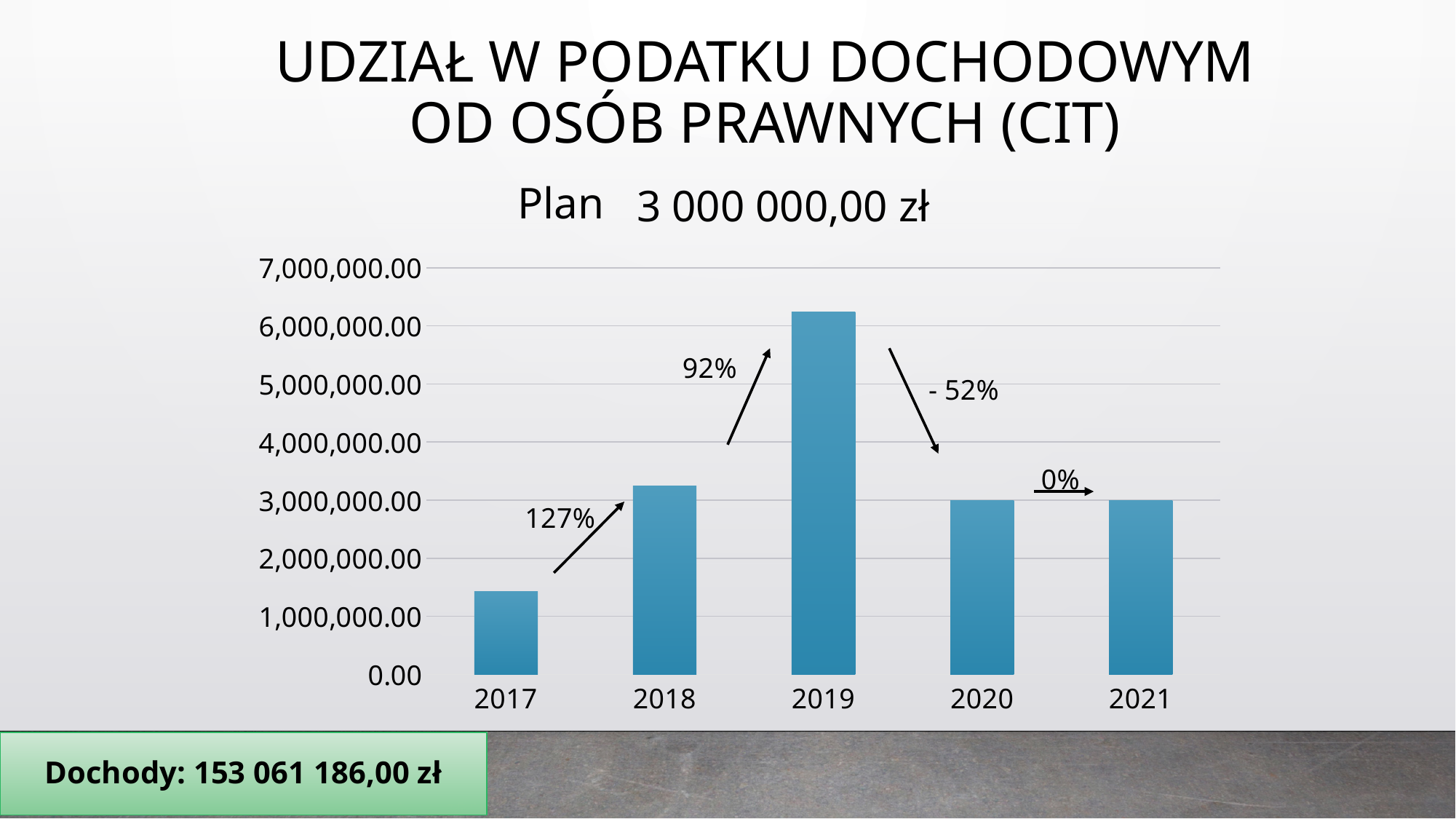
Is the value for 2017 greater or less than 2,000,000.00? less Is the value for 2018 greater or less than 3,000,000.00? greater Which year has the larger value, 2018 or 2020? 2018 Which year has the highest bar in the chart? 2019 How many years are shown on the x axis of the chart? 5 What percentage change is annotated between the 2018 and 2019 bars? 92% What kind of chart is shown on the slide? bar chart What plan value is stated above the chart? 3 000 000,00 zł What percentage change is annotated between the 2019 and 2020 bars? - 52% What percentage change is annotated between the 2017 and 2018 bars? 127% Which year has the lowest bar in the chart? 2017 Is the value for 2019 greater or less than 6,000,000.00? greater